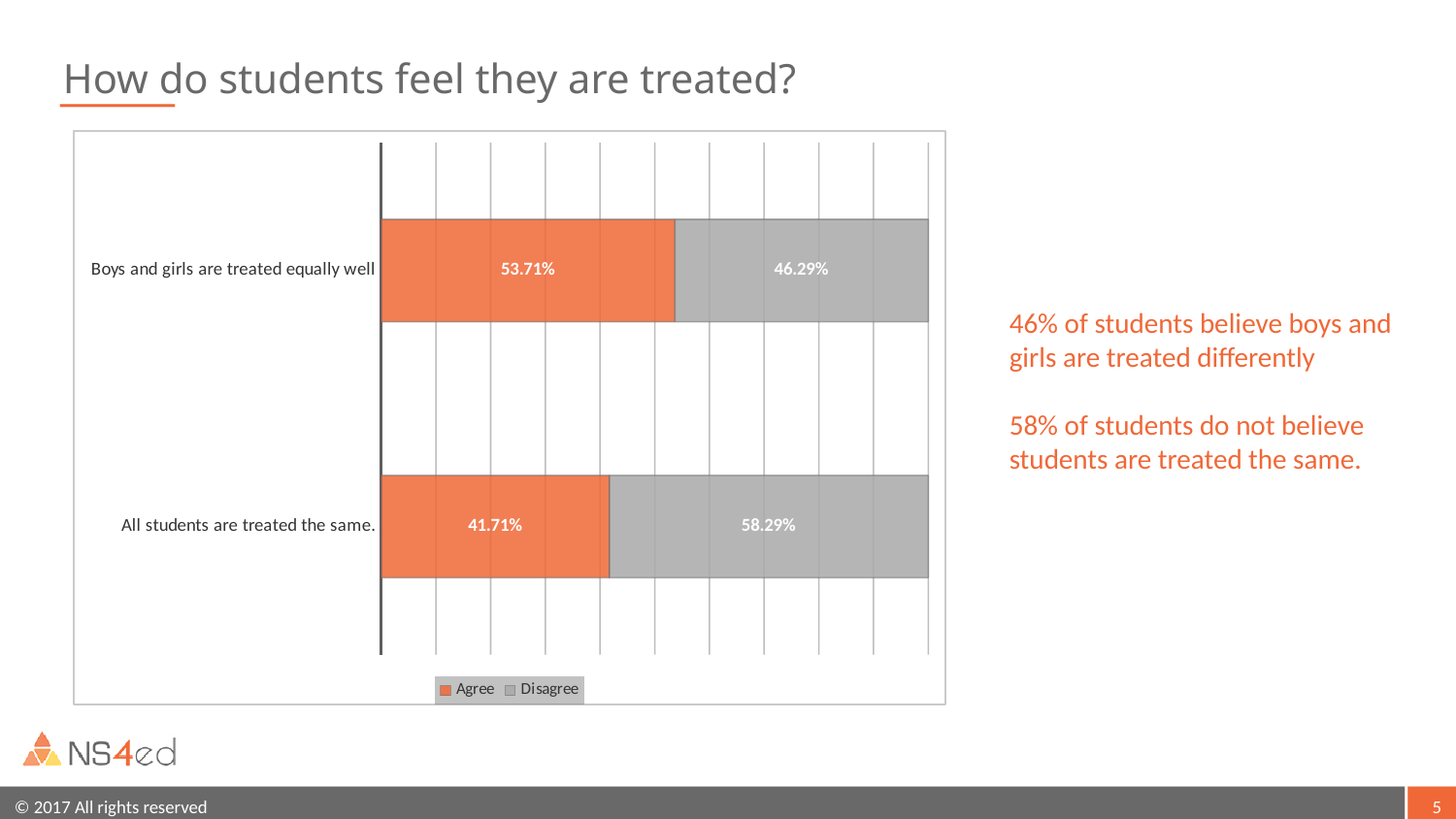
What type of chart is shown on the slide? Stacked bar chart What percentage of students agree that boys and girls are treated equally well? 53.71% What is the difference between the Agree percentages for the two statements? 12.00% What percentage of students disagree that all students are treated the same? 58.29% How many series does the legend list? 2 What percentage of students disagree that boys and girls are treated equally well? 46.29% Which statement has the lower Agree percentage? All students are treated the same. How many statements (categories) are shown in the chart? 2 For the statement 'All students are treated the same.', is the Agree or Disagree share larger? Disagree What percentage of students agree that all students are treated the same? 41.71% Which statement has the higher Agree percentage? Boys and girls are treated equally well Which colour represents Agree in the chart? Orange